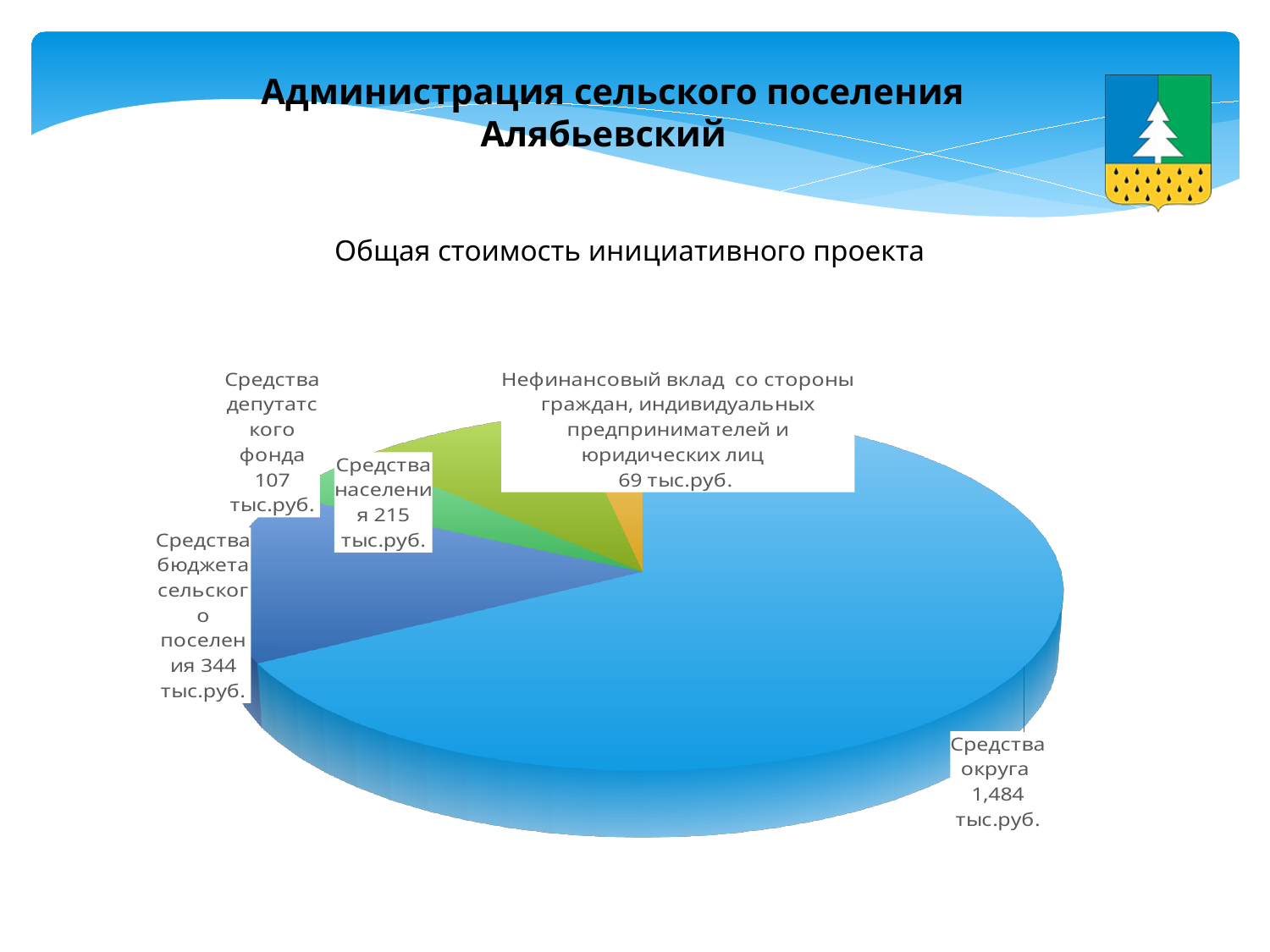
How many slices does the pie chart have? 5 What kind of chart is shown on the slide? Pie chart What is the difference between Средства округа and Средства бюджета сельского поселения? 1,140 тыс.руб. What is the value for Средства округа? 1,484 тыс.руб. What is the value for Нефинансовый вклад со стороны граждан, индивидуальных предпринимателей и юридических лиц? 69 тыс.руб. Which funding source has the largest value? Средства округа Which is larger, Средства населения or Средства депутатского фонда? Средства населения What is the value for Средства населения? 215 тыс.руб. What is the value for Средства депутатского фонда? 107 тыс.руб. What is the value for Средства бюджета сельского поселения? 344 тыс.руб. What is the difference between Средства населения and Средства депутатского фонда? 108 тыс.руб. Which funding source has the smallest value? Нефинансовый вклад со стороны граждан, индивидуальных предпринимателей и юридических лиц